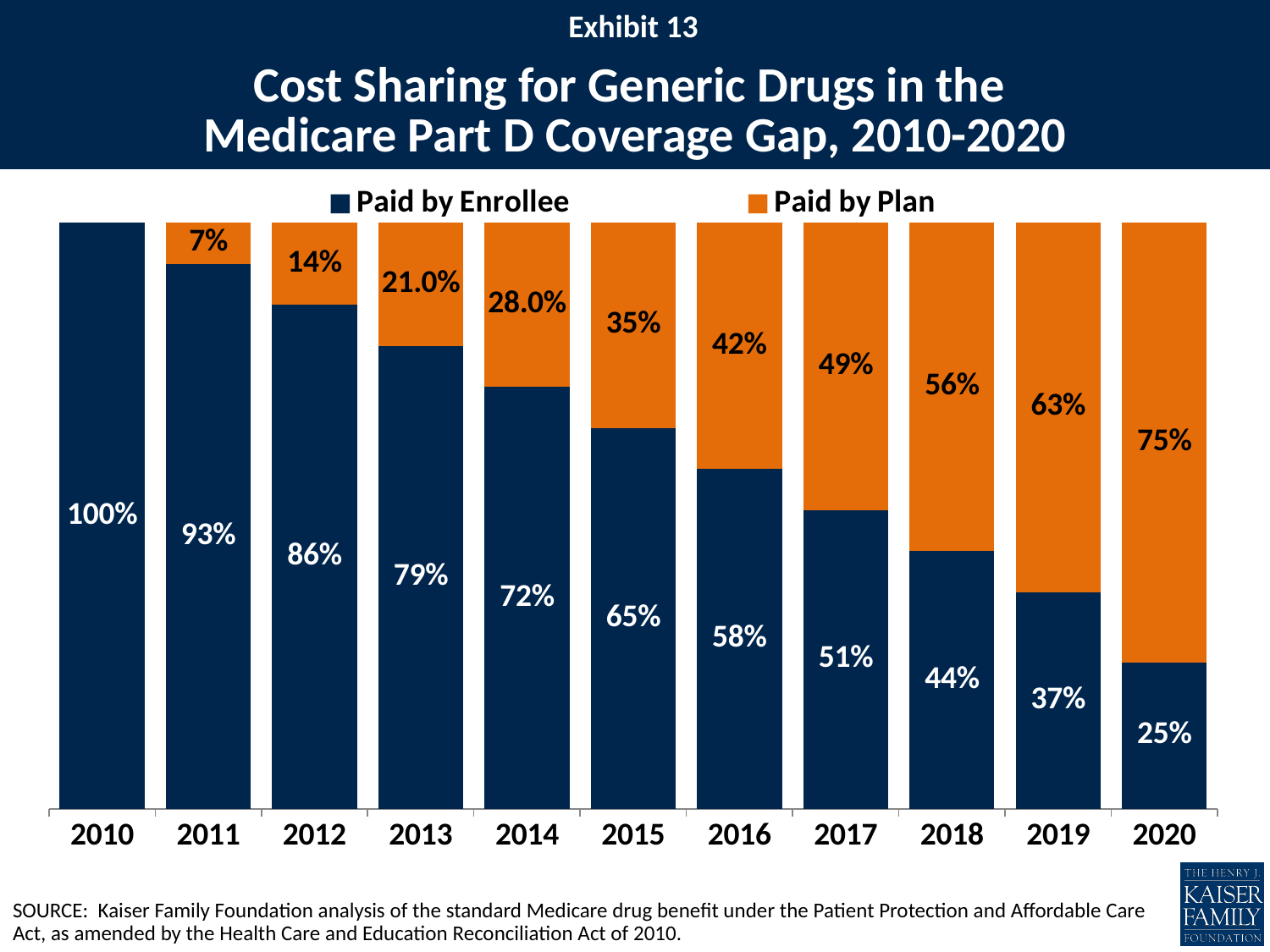
How many years are shown on the x axis? 11 What percentage was paid by the plan in 2013? 21.0% What percentage was paid by the enrollee in 2014? 72% What kind of chart is shown on the slide? Stacked bar chart What is the total of the stacked bar for 2018? 100% In which year is the share paid by the enrollee the highest? 2010 What percentage was paid by the plan in 2020? 75% Which is larger in 2016: the share paid by the enrollee or the share paid by the plan? Paid by Enrollee How many series does the legend list? 2 What is the difference between the share paid by the enrollee in 2011 and in 2019? 56% Does the share paid by the enrollee rise or fall from 2010 to 2020? Fall In which year is the share paid by the plan the lowest (among years where a plan share is shown)? 2011